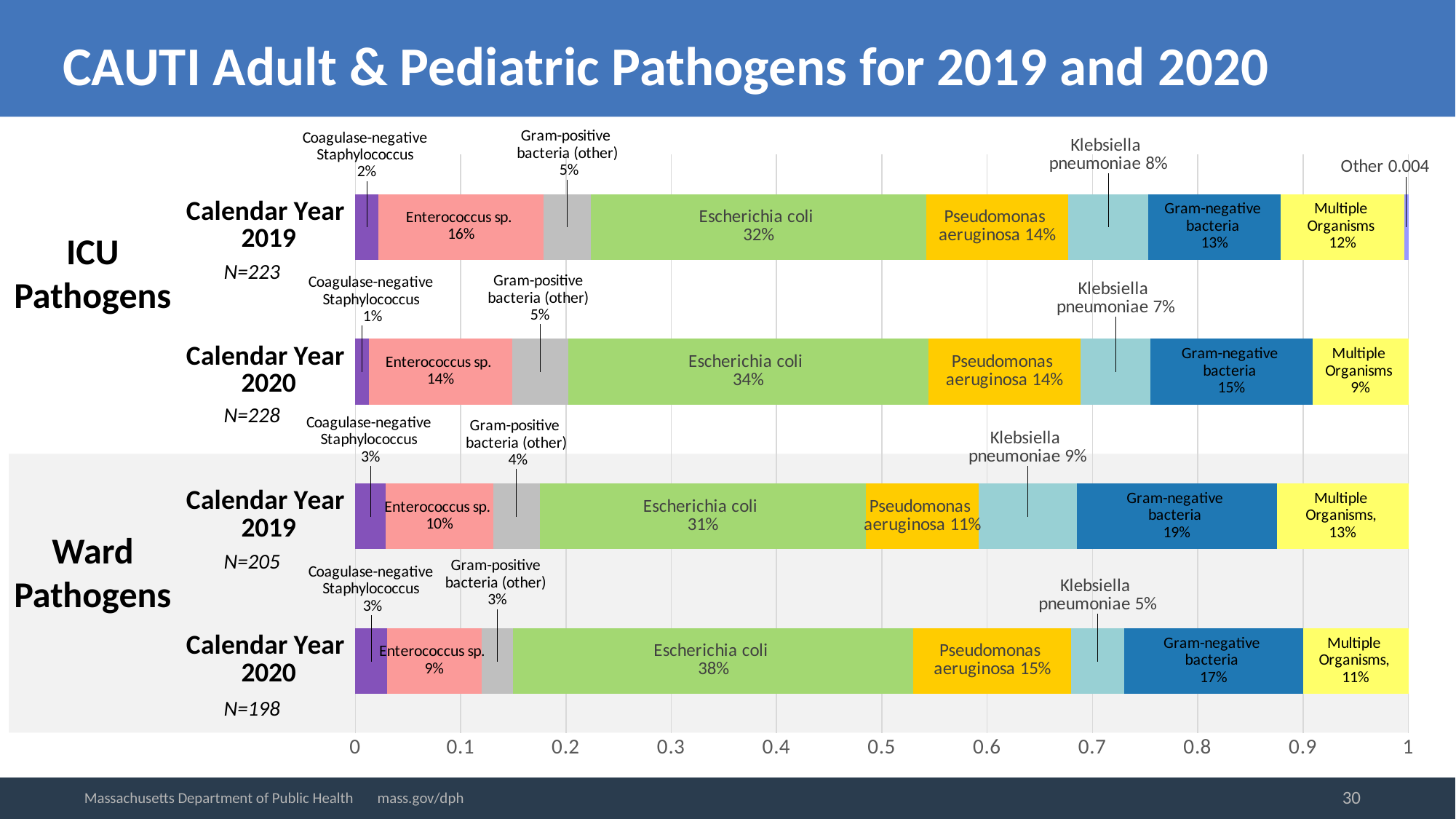
What share of Ward pathogens in Calendar Year 2019 was Gram-negative bacteria? 19% By how many percentage points did the Escherichia coli share of Ward pathogens change from Calendar Year 2019 to Calendar Year 2020? 7 percentage points Did the Escherichia coli share of ICU pathogens rise or fall from Calendar Year 2019 to Calendar Year 2020? Rise What share of Ward pathogens in Calendar Year 2020 was Enterococcus sp.? 9% What is the N value shown for Ward Pathogens Calendar Year 2019? N=205 How many stacked bars does the chart show? 4 Which is larger: the Pseudomonas aeruginosa share for ICU Calendar Year 2019 or for Ward Calendar Year 2019? ICU Calendar Year 2019 Which labeled segment has the smallest share in the ICU Pathogens Calendar Year 2019 bar? Other What share of ICU pathogens in Calendar Year 2019 was Escherichia coli? 32% What kind of chart is shown on the slide? Stacked bar chart What share of ICU pathogens in Calendar Year 2020 was Klebsiella pneumoniae? 7% Which pathogen has the largest share in the Ward Pathogens Calendar Year 2020 bar? Escherichia coli